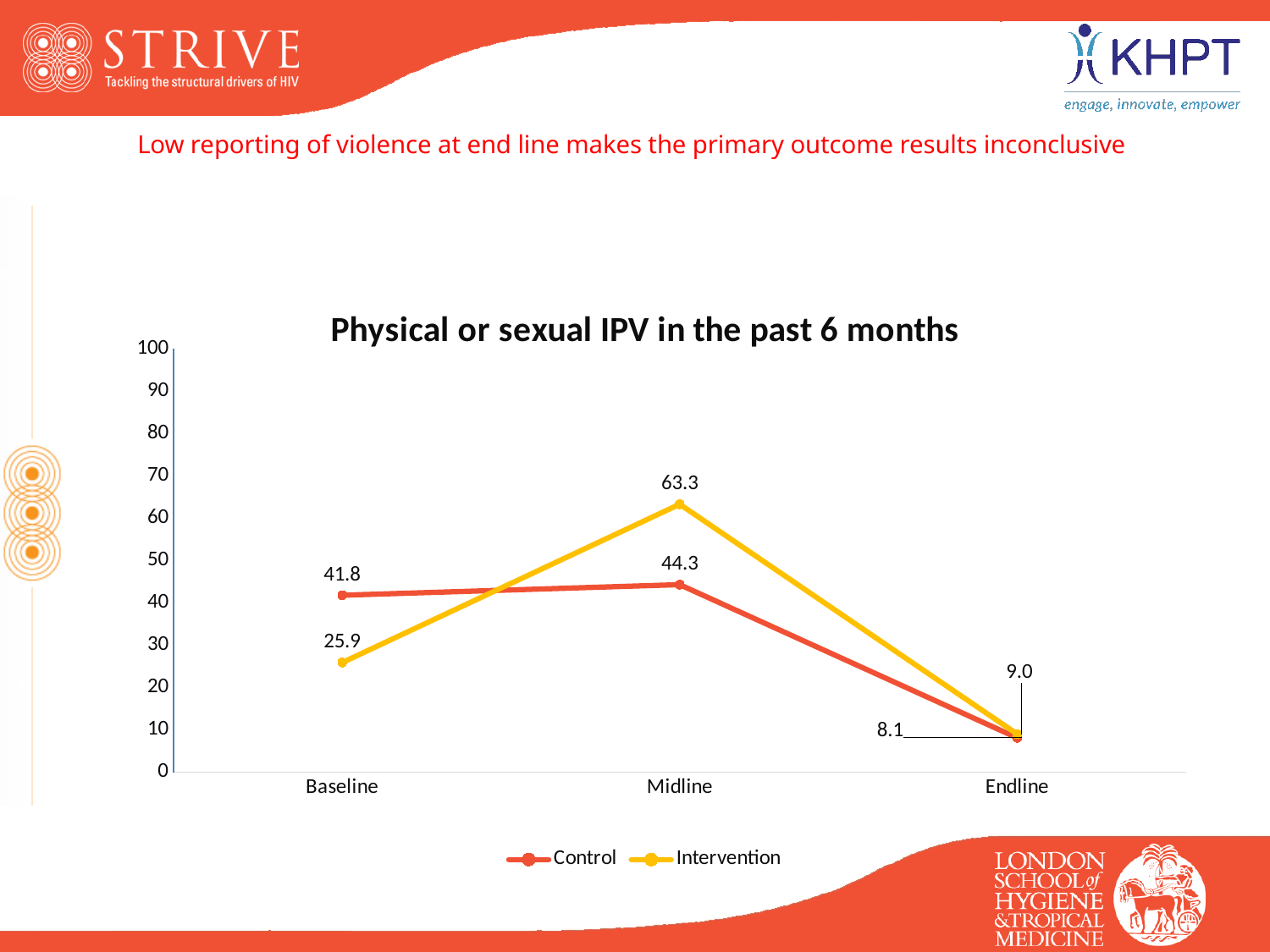
How many series does the legend list? 2 What is the difference between the Intervention and Control values at Midline? 19.0 What type of chart is shown on the slide? Line chart At which time point is the Intervention series highest? Midline How many time points are shown on the x axis? 3 What is the title of the chart? Physical or sexual IPV in the past 6 months What is the Intervention value at Midline? 63.3 Does the Control series rise or fall from Midline to Endline? Fall At Baseline, which series has the larger value, Control or Intervention? Control What is the Intervention value at Endline? 9.0 What is the Control value at Baseline? 41.8 At which time point is the Control series lowest? Endline